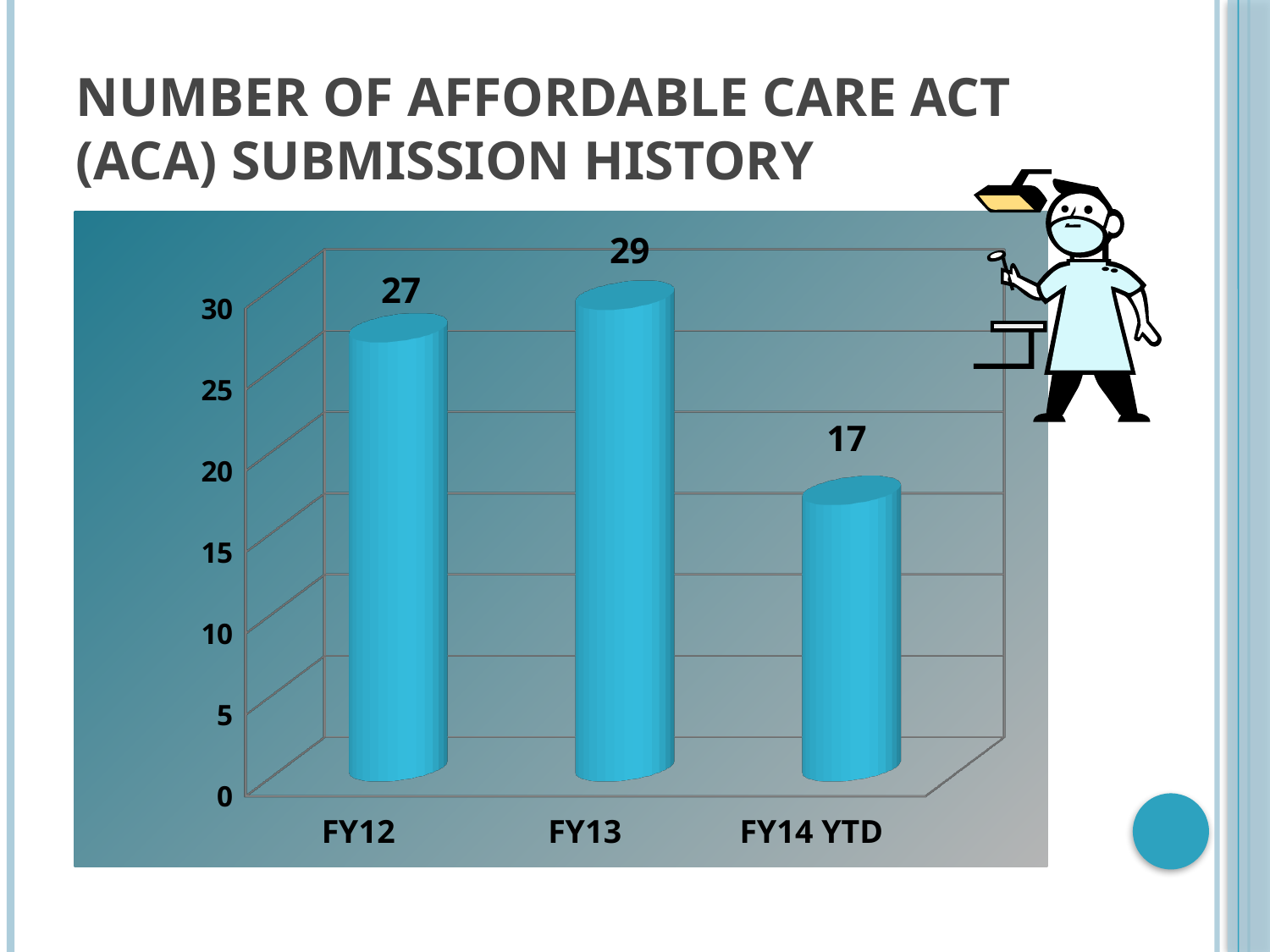
How many categories are shown on the x axis? 3 Which category has the lowest value? FY14 YTD What is the difference between the values for FY13 and FY12? 2 Is the value for FY14 YTD greater or less than 20? less What is the title of the slide? Number of Affordable Care Act (ACA) Submission History What is the value for FY13? 29 What is the value for FY14 YTD? 17 What kind of chart is shown on the slide? bar chart What is the value for FY12? 27 Which category has the highest value? FY13 Which is larger, the value for FY12 or the value for FY14 YTD? FY12 What is the difference between the values for FY13 and FY14 YTD? 12